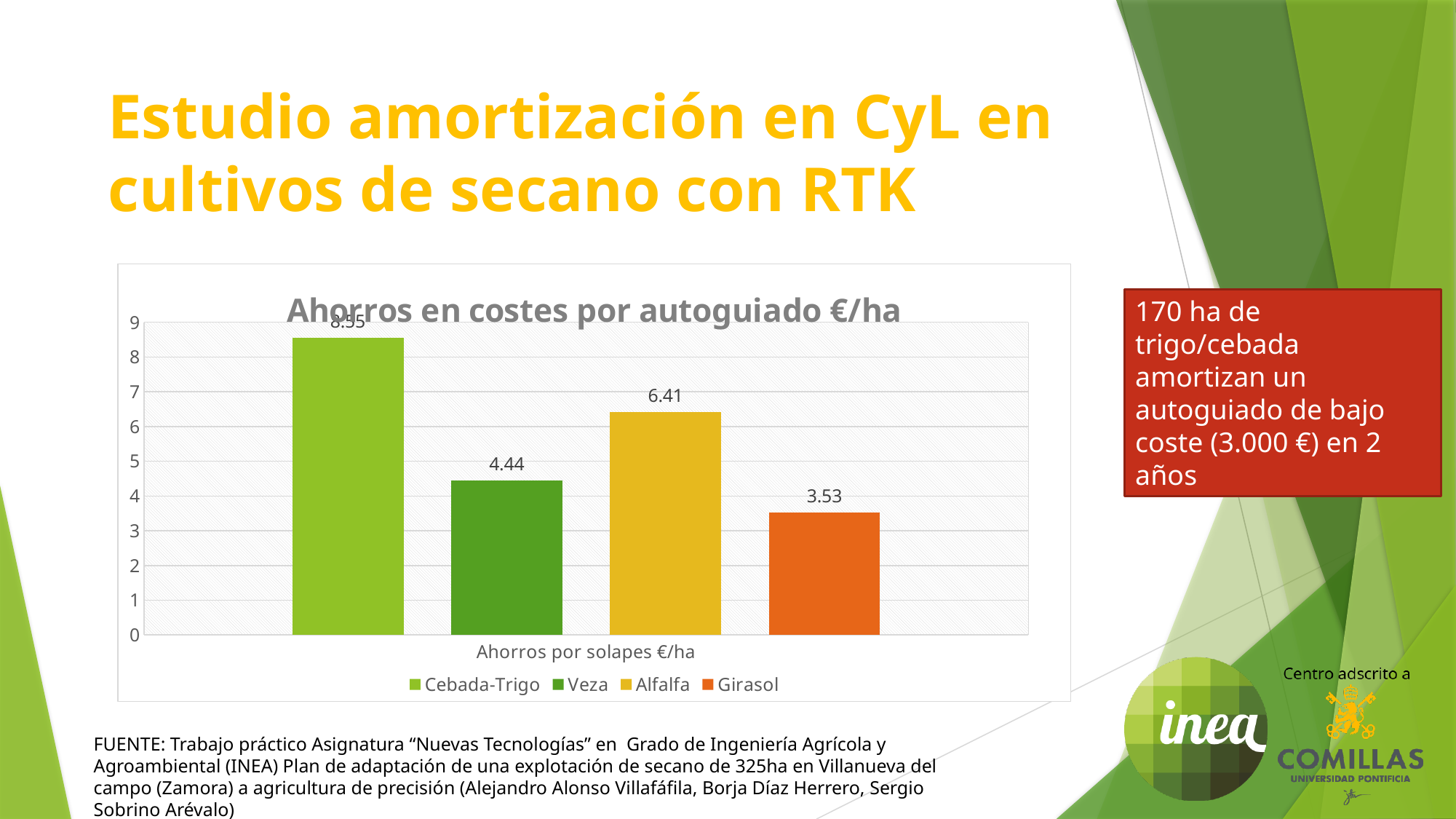
Which series has the highest value in the chart? Cebada-Trigo Which is larger, the value for Alfalfa or the value for Veza? Alfalfa What is the title of the chart? Ahorros en costes por autoguiado €/ha What kind of chart is shown on the slide? Bar chart What is the value for Girasol in the chart? 3.53 What is the value for Veza in the chart? 4.44 What is the value for Alfalfa in the chart? 6.41 Is the value for Cebada-Trigo greater or less than 8? greater What is the difference between the values for Alfalfa and Veza? 1.97 What is the difference between the values for Veza and Girasol? 0.91 How many series does the legend list? 4 Which series has the lowest value in the chart? Girasol